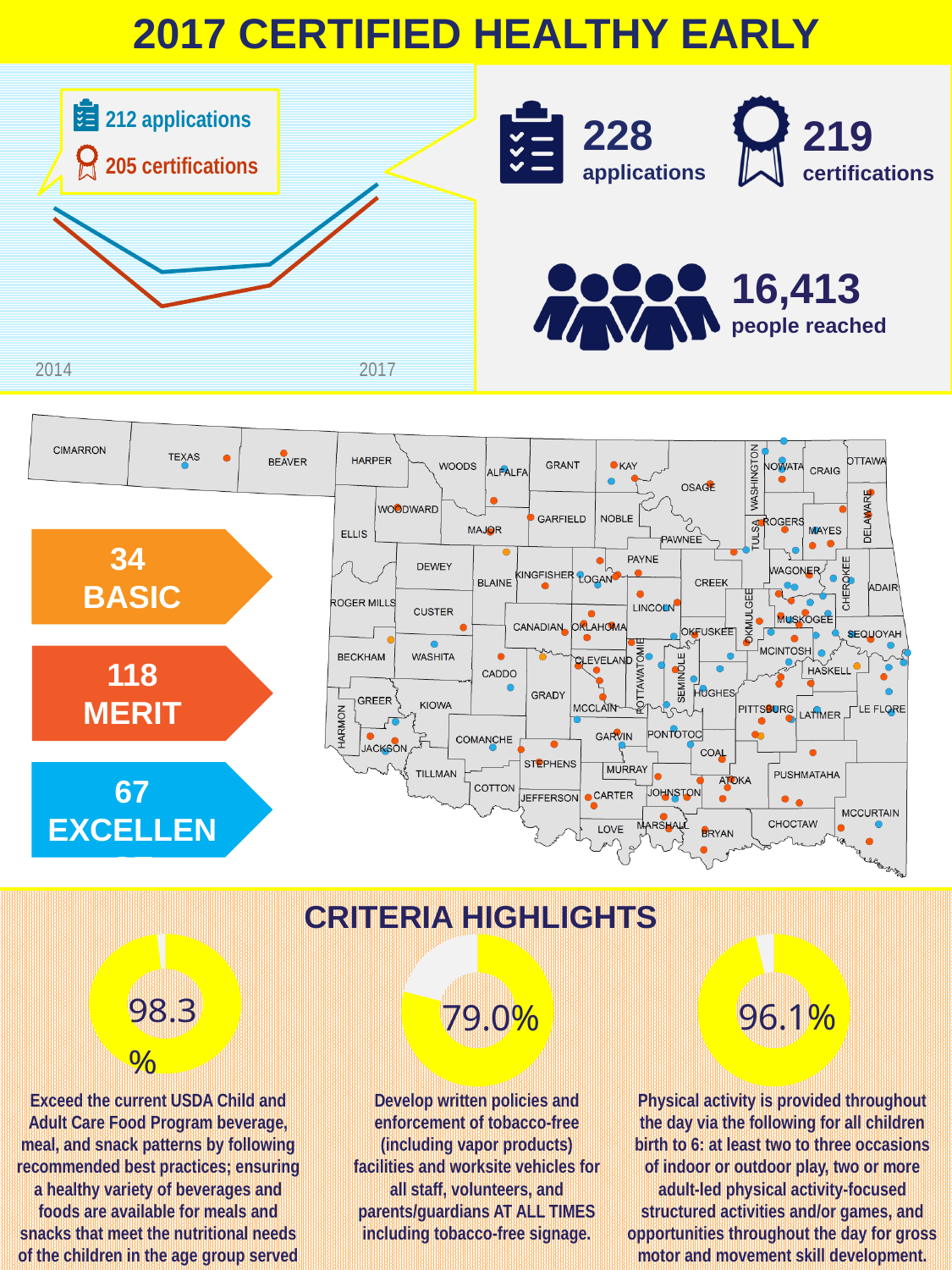
In the Criteria Highlights section, what percentage is shown in the donut chart for exceeding the USDA Child and Adult Care Food Program patterns? 98.3% What kind of chart is shown in the top-left panel with the 2014 and 2017 axis labels? line chart In the Criteria Highlights section, which donut chart shows the lowest percentage? Develop written policies and enforcement of tobacco-free facilities (79.0%) On the line chart in the top-left panel, which line is higher throughout, the blue line or the red line? the blue line On the line chart in the top-left panel, does the blue line end higher or lower in 2017 than it started in 2014? higher In the Criteria Highlights section, which donut chart shows the highest percentage? Exceed the current USDA Child and Adult Care Food Program patterns (98.3%) How many donut charts are shown in the Criteria Highlights section? 3 On the line chart in the top-left panel, do the lines rise or fall between the first and second plotted points? fall In the Criteria Highlights section, what is the difference in percentage points between the physical activity donut (96.1%) and the tobacco-free policies donut (79.0%)? 17.1 percentage points How many lines are plotted on the line chart in the top-left panel? 2 On the line chart in the top-left panel, which two years are labelled on the x axis? 2014 and 2017 In the Criteria Highlights section, what percentage is shown in the donut chart for developing written tobacco-free policies? 79.0%